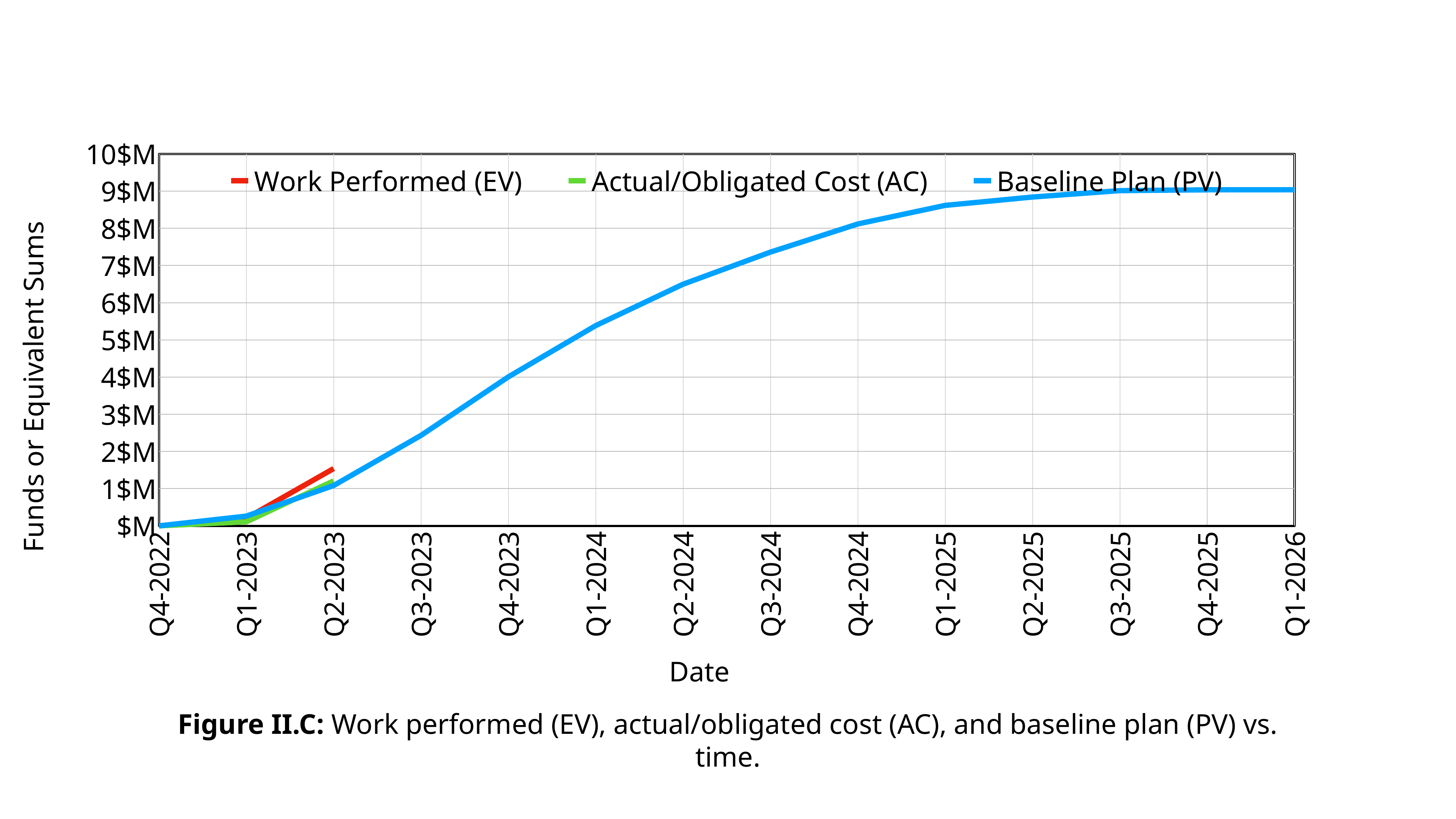
Is the Baseline Plan (PV) value at Q3-2023 greater or less than 3$M? less How many quarter labels are shown along the x axis? 14 Does the Baseline Plan (PV) line rise or fall from Q4-2022 to Q1-2026? rise What is the label of the y axis? Funds or Equivalent Sums Is the Baseline Plan (PV) value at Q2-2024 greater or less than 6$M? greater Is the Baseline Plan (PV) value at Q4-2024 greater or less than 7$M? greater What kind of chart is shown on the slide? line chart How many series does the legend list? 3 At Q2-2023, which is higher: Work Performed (EV) or Actual/Obligated Cost (AC)? Work Performed (EV) Which series is drawn in blue? Baseline Plan (PV)